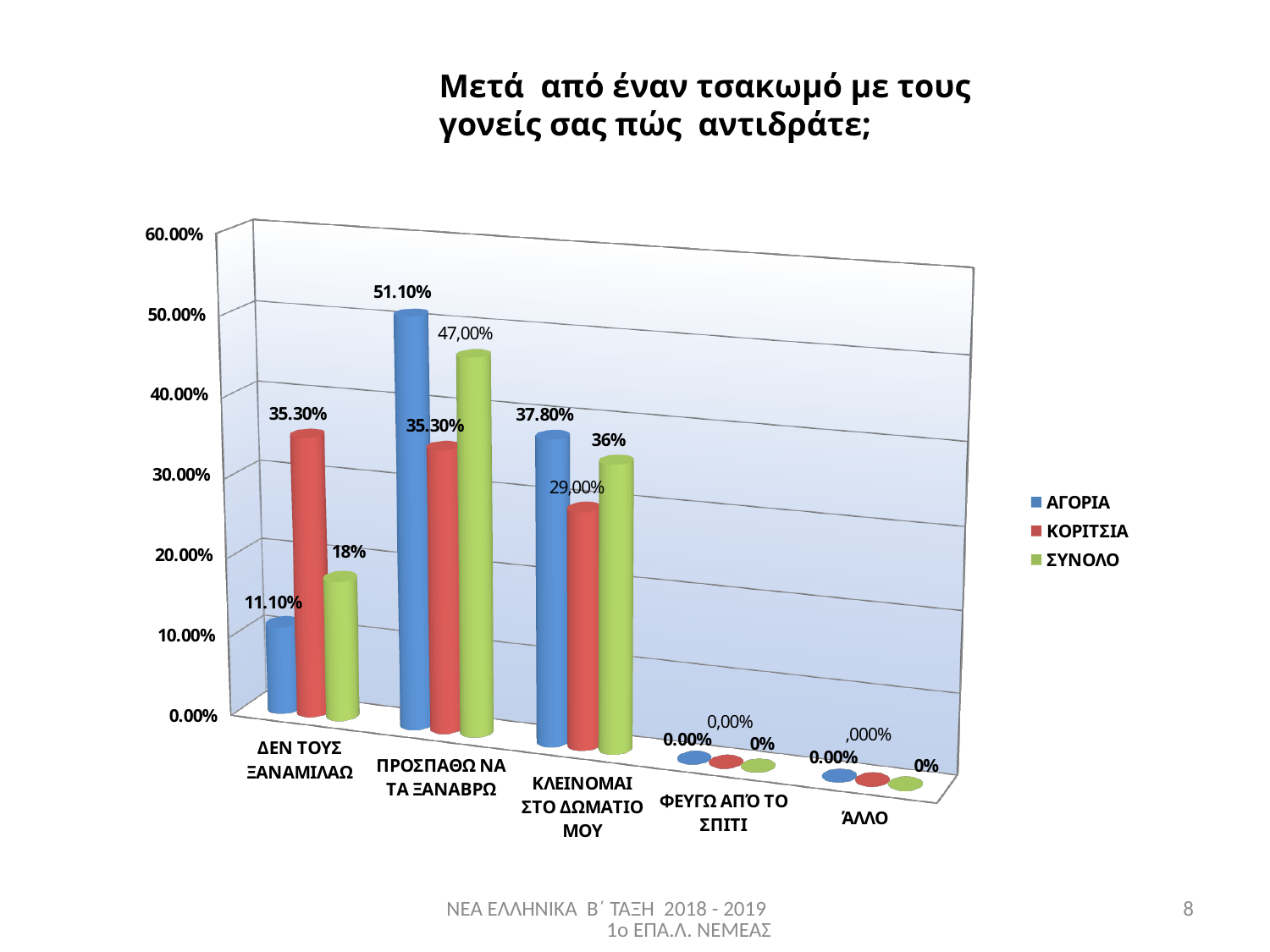
In the category ΔΕΝ ΤΟΥΣ ΞΑΝΑΜΙΛΑΩ, which is larger: the value for ΑΓΟΡΙΑ or the value for ΚΟΡΙΤΣΙΑ? ΚΟΡΙΤΣΙΑ What is the difference between the ΑΓΟΡΙΑ and ΚΟΡΙΤΣΙΑ values in the category ΠΡΟΣΠΑΘΩ ΝΑ ΤΑ ΞΑΝΑΒΡΩ? 15.80% Which category has the lowest value for ΣΥΝΟΛΟ among the three categories with non-zero values? ΔΕΝ ΤΟΥΣ ΞΑΝΑΜΙΛΑΩ What kind of chart is shown on the slide? bar chart How many series does the legend list? 3 What is the value for ΚΟΡΙΤΣΙΑ in the category ΔΕΝ ΤΟΥΣ ΞΑΝΑΜΙΛΑΩ? 35.30% What is the value for ΣΥΝΟΛΟ in the category ΚΛΕΙΝΟΜΑΙ ΣΤΟ ΔΩΜΑΤΙΟ ΜΟΥ? 36% Which category has the highest value for ΑΓΟΡΙΑ? ΠΡΟΣΠΑΘΩ ΝΑ ΤΑ ΞΑΝΑΒΡΩ What is the value for ΑΓΟΡΙΑ in the category ΠΡΟΣΠΑΘΩ ΝΑ ΤΑ ΞΑΝΑΒΡΩ? 51.10% Is the value for ΑΓΟΡΙΑ in the category ΚΛΕΙΝΟΜΑΙ ΣΤΟ ΔΩΜΑΤΙΟ ΜΟΥ greater or less than 30.00%? greater How many categories are shown on the x axis of the chart? 5 What is the value for ΑΓΟΡΙΑ in the category ΔΕΝ ΤΟΥΣ ΞΑΝΑΜΙΛΑΩ? 11.10%